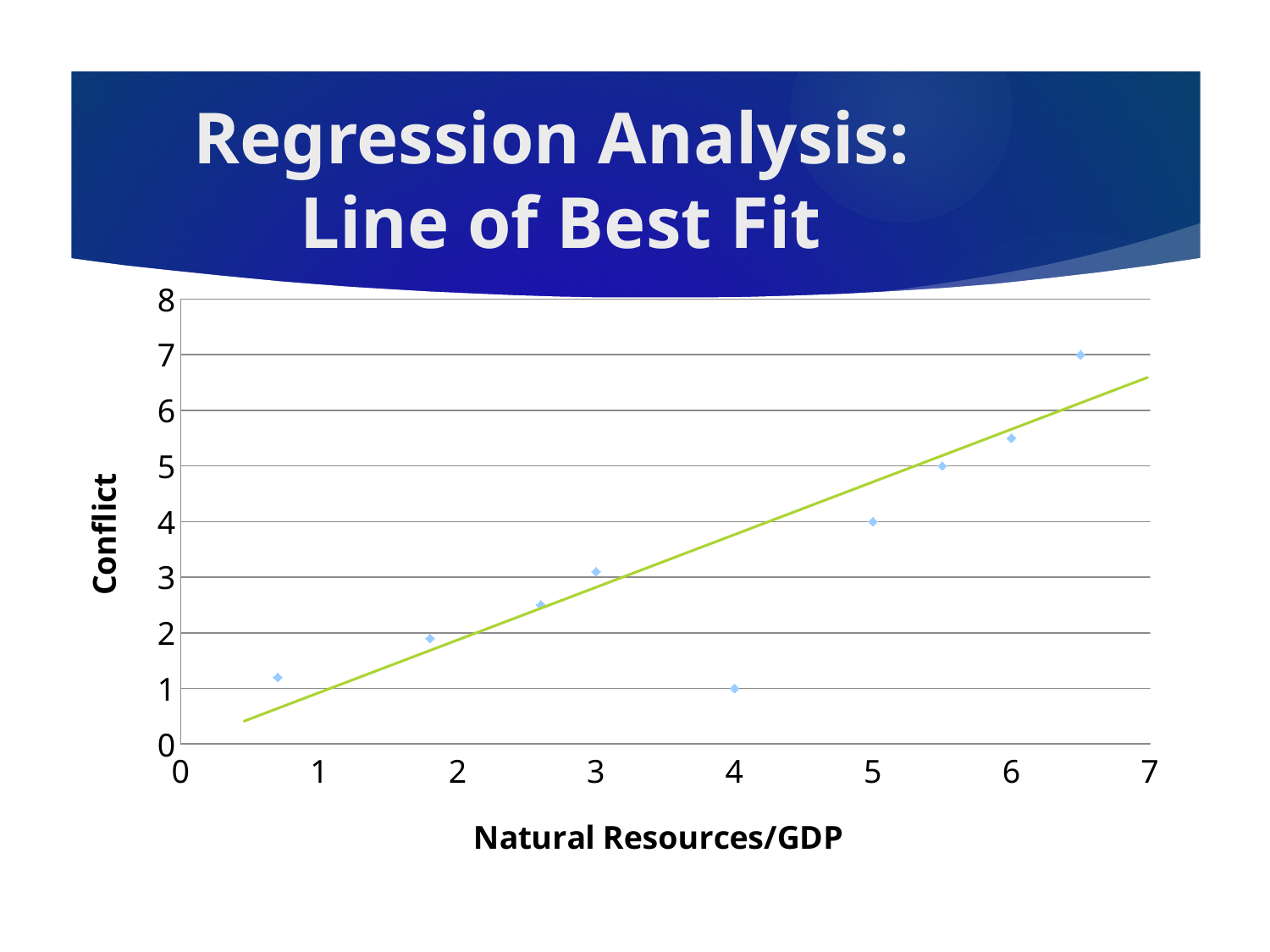
Which has the larger Conflict value: the data point at Natural Resources/GDP = 4 or the one at 5? the point at 5 What kind of chart is shown on the slide? scatter plot What is the Conflict value of the data point at Natural Resources/GDP = 4? 1 What is the Conflict value of the highest data point on the chart? 7 Is the Conflict value for the data point at Natural Resources/GDP = 6 greater or less than 5? greater Does the line of best fit rise or fall as Natural Resources/GDP increases? rises What is the Conflict value of the lowest data point on the chart? 1 What is the label of the horizontal axis? Natural Resources/GDP What is the label of the vertical axis? Conflict How many data points are plotted on the chart? 9 What is the Conflict value of the data point at Natural Resources/GDP = 5? 4 Is the Conflict value for the leftmost data point greater or less than 2? less